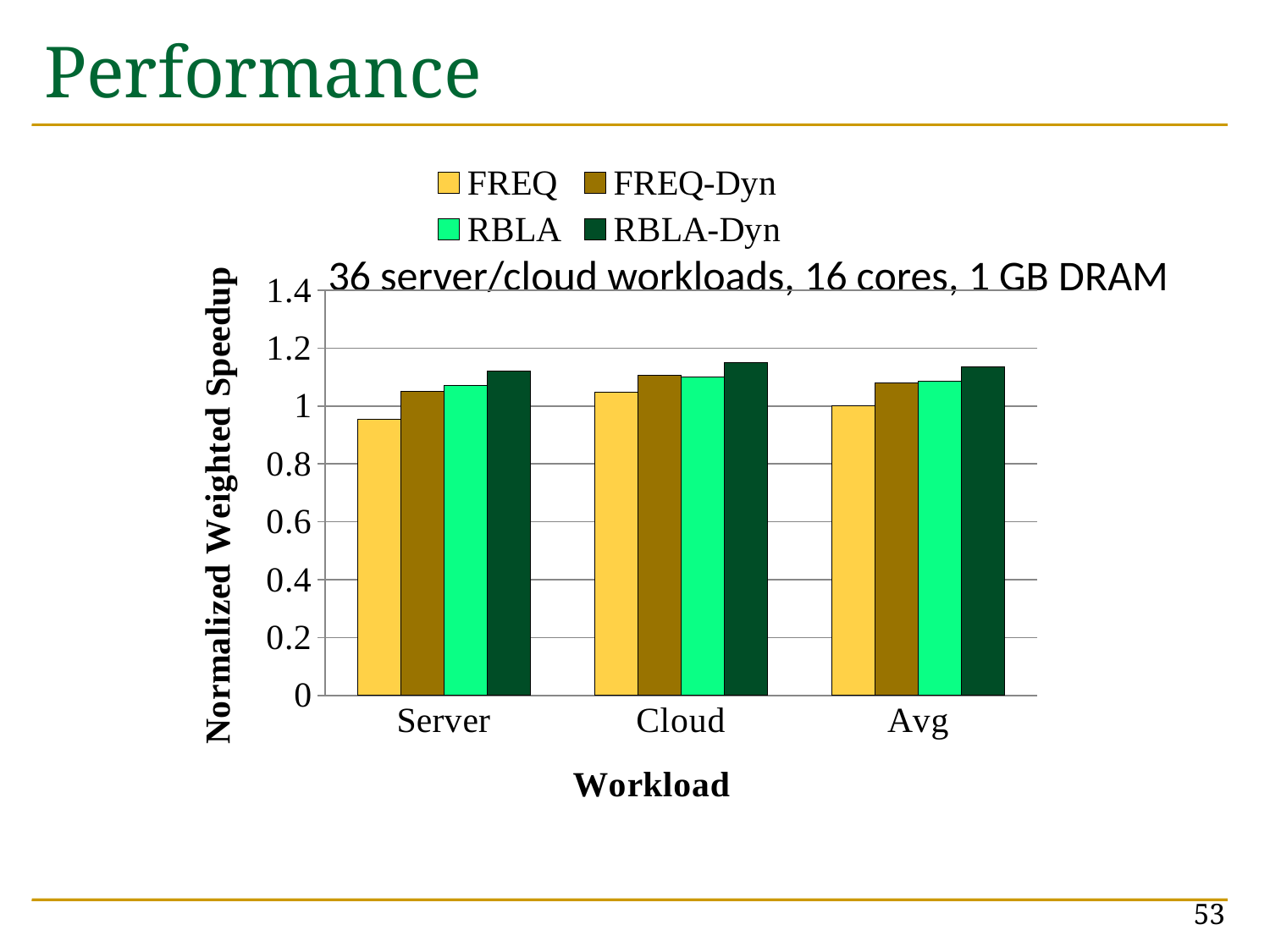
What is the title of the x axis? Workload Which is larger: the FREQ value for Server or the FREQ value for Cloud? Cloud Is the value for FREQ on the Server workload greater or less than 1? less Which series has the highest bar for the Server workload? RBLA-Dyn How many workload categories are shown on the x axis? 3 What is the title of the y axis? Normalized Weighted Speedup Which series has the lowest bar for the Server workload? FREQ How many series does the legend list? 4 Is the value for RBLA-Dyn on the Cloud workload greater or less than 1? greater Which series has the lowest bar for the Avg workload? FREQ What kind of chart is shown on the slide? bar chart Which series has the highest bar for the Cloud workload? RBLA-Dyn